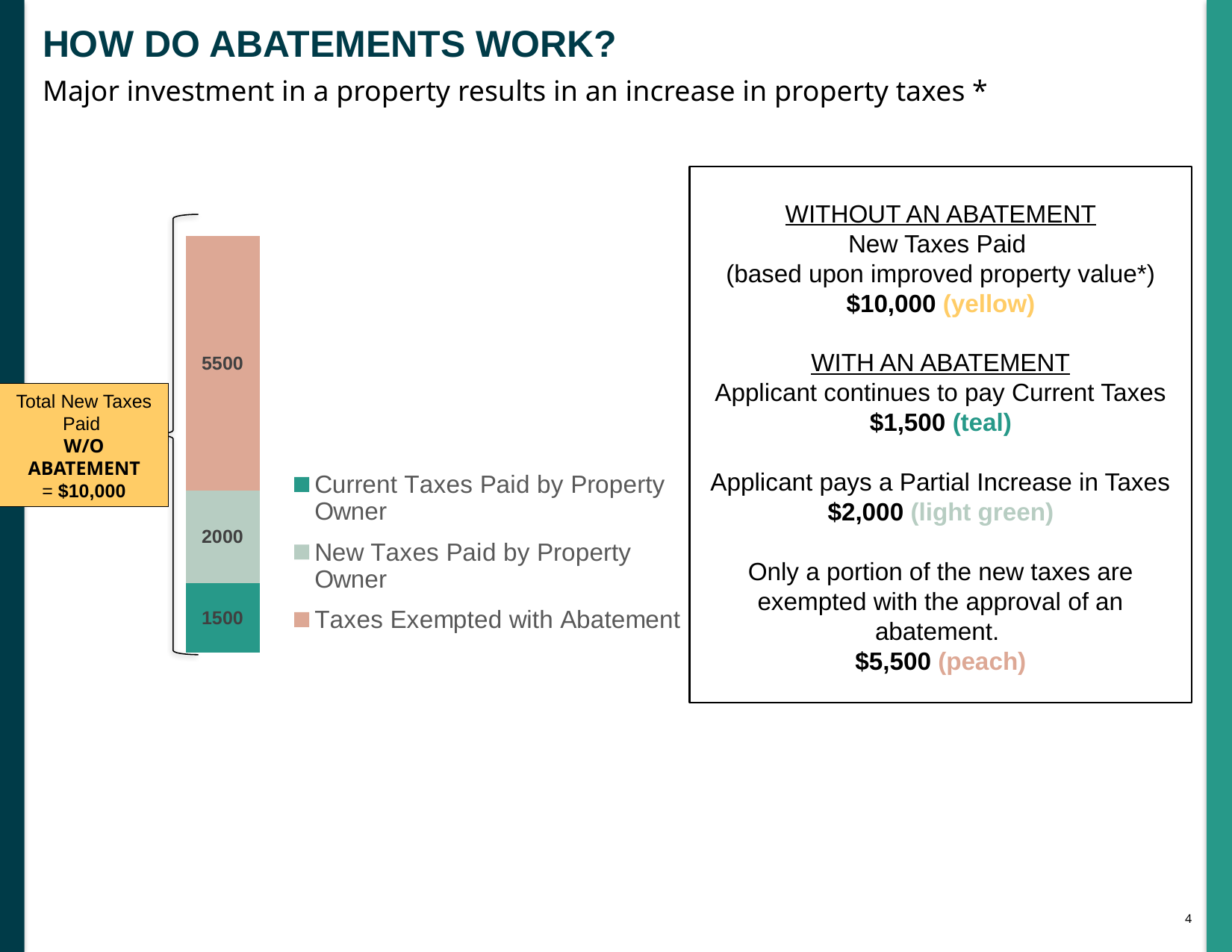
What is the difference between the Taxes Exempted with Abatement segment and the New Taxes Paid by Property Owner segment? 3500 What is the difference between the New Taxes Paid by Property Owner segment and the Current Taxes Paid by Property Owner segment? 500 How many series does the legend list? 3 Which is larger: the Taxes Exempted with Abatement segment or the Current Taxes Paid by Property Owner segment? Taxes Exempted with Abatement Which series has the largest segment in the stacked bar? Taxes Exempted with Abatement What is the total of the stacked bar? 9000 What is the value of the Current Taxes Paid by Property Owner segment in the stacked bar? 1500 What is the value of the Taxes Exempted with Abatement segment in the stacked bar? 5500 Which series has the smallest segment in the stacked bar? Current Taxes Paid by Property Owner What is the value of the New Taxes Paid by Property Owner segment in the stacked bar? 2000 What kind of chart is shown on the slide? Stacked bar chart Which series is shown in the peach colour in the chart? Taxes Exempted with Abatement